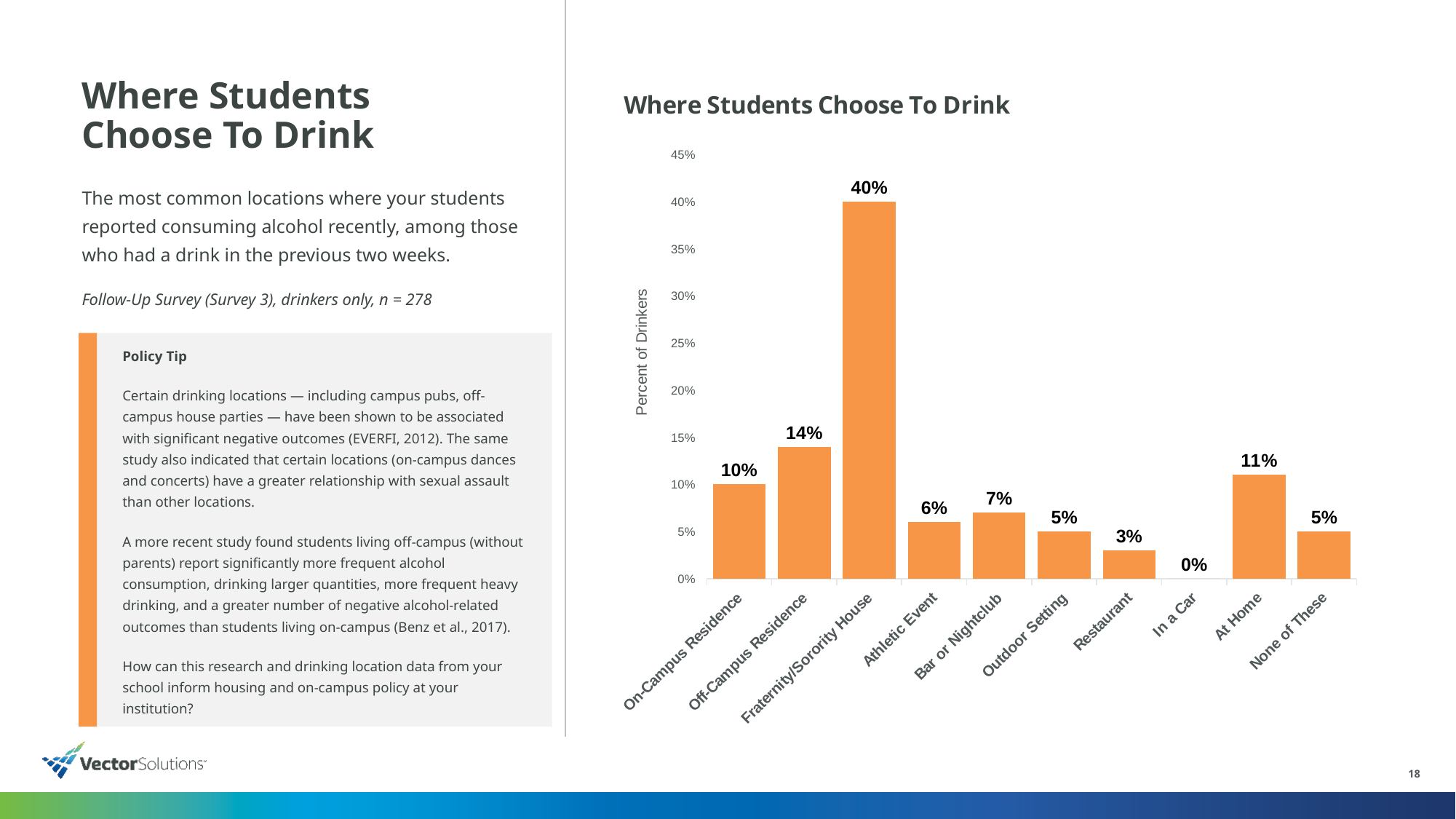
How many locations are shown on the x axis of the chart? 10 What kind of chart is shown on the slide? Bar chart What is the difference between the values for At Home and On-Campus Residence? 1% Which location has the highest percentage of drinkers? Fraternity/Sorority House Is the value for Fraternity/Sorority House greater or less than 35%? greater Which location has the lowest percentage of drinkers? In a Car What is the label of the y axis of the chart? Percent of Drinkers What percentage of drinkers reported drinking at a Fraternity/Sorority House? 40% What percentage of drinkers reported drinking at a Restaurant? 3% What is the value for Off-Campus Residence? 14% What is the difference between the values for Fraternity/Sorority House and Off-Campus Residence? 26% Which is larger, the value for Bar or Nightclub or the value for Athletic Event? Bar or Nightclub